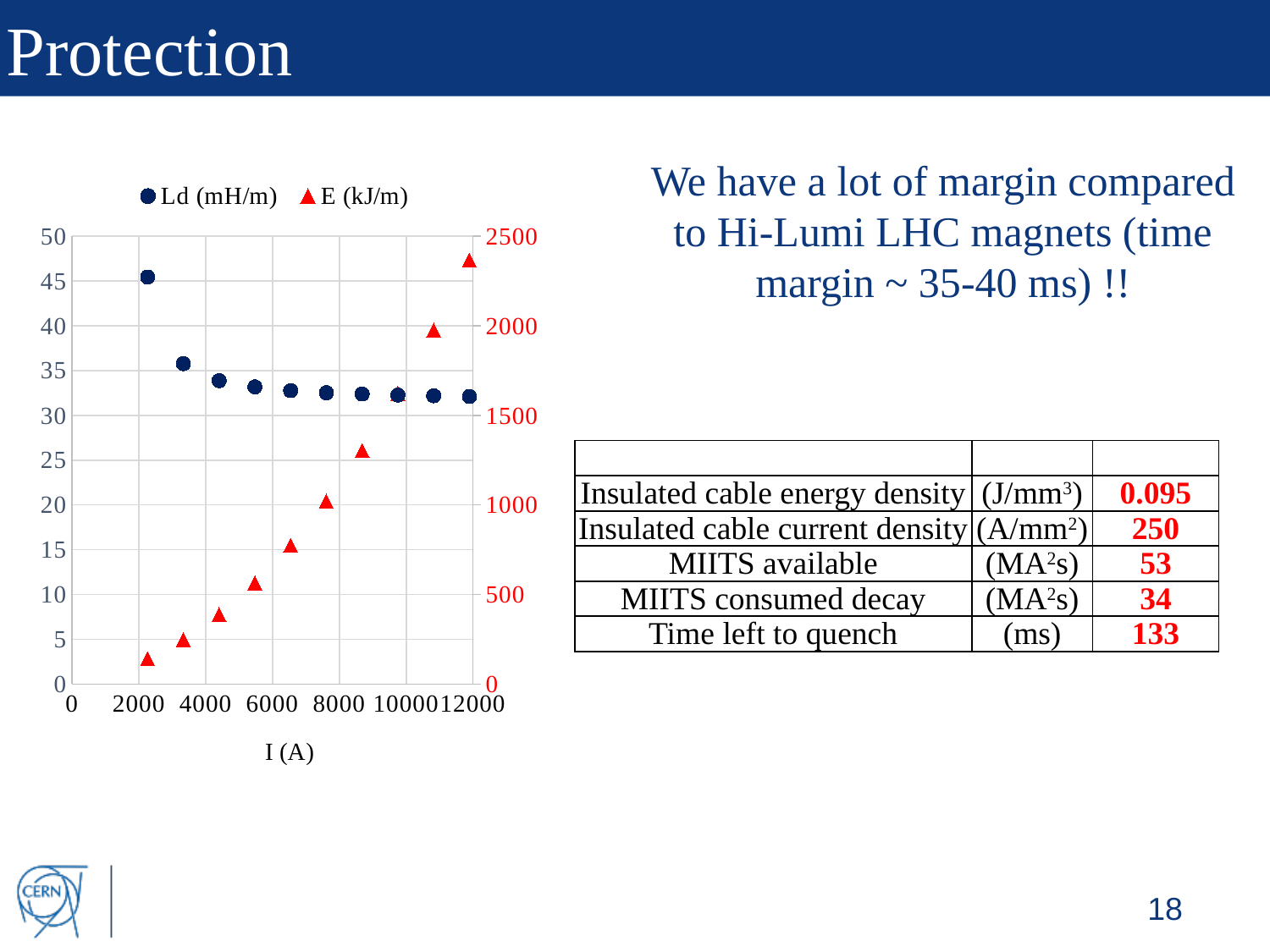
What are the two series named in the chart legend? Ld (mH/m) and E (kJ/m) What is the title of the x axis of the chart? I (A) Does Ld (mH/m) rise or fall as the current I increases along the x axis? fall Does E (kJ/m) rise or fall as the current I increases along the x axis? rise Which is larger: the Ld (mH/m) value at the lowest plotted current or at 12000 A? at the lowest plotted current How many Ld (mH/m) data points are plotted on the chart? 10 Is the Ld (mH/m) value at 12000 A greater or less than 35? less Is the E (kJ/m) value at the lowest plotted current greater or less than 500? less Is the E (kJ/m) value at 12000 A greater or less than 2000? greater How many series does the chart legend list? 2 What kind of chart is shown on the slide? scatter chart